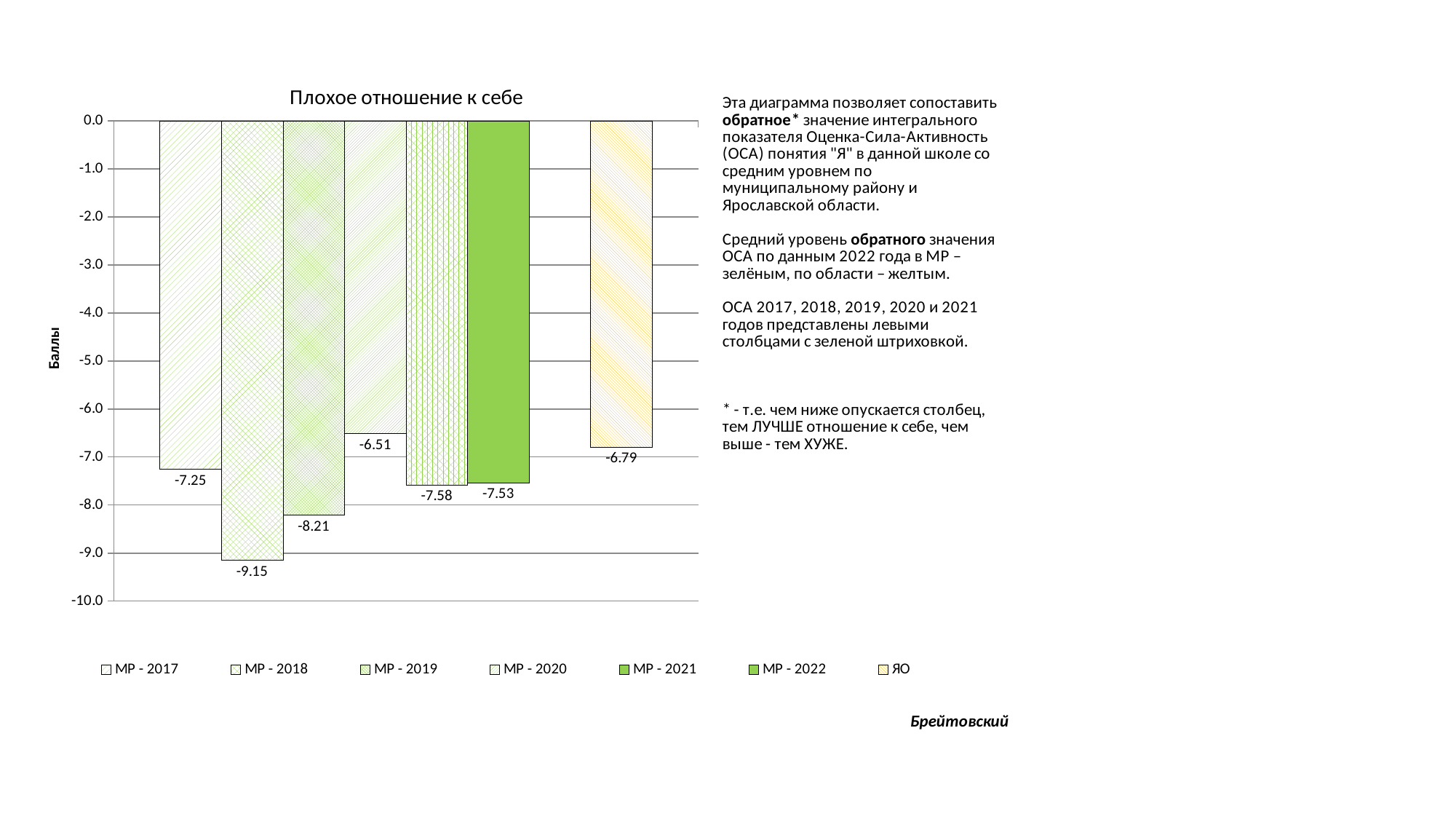
Which series has the lowest value? МР - 2018 What is the title of the chart? Плохое отношение к себе What is the value for МР - 2020? -6.51 What is the value for МР - 2022? -7.53 What kind of chart is shown? bar chart What is the difference between the values for МР - 2019 and МР - 2017? 0.96 What is the value for ЯО? -6.79 What is the value for МР - 2018? -9.15 How many series does the legend list? 7 How many bars are plotted on the chart? 7 Which is larger, the value for МР - 2022 or the value for ЯО? ЯО Which series has the highest value? МР - 2020